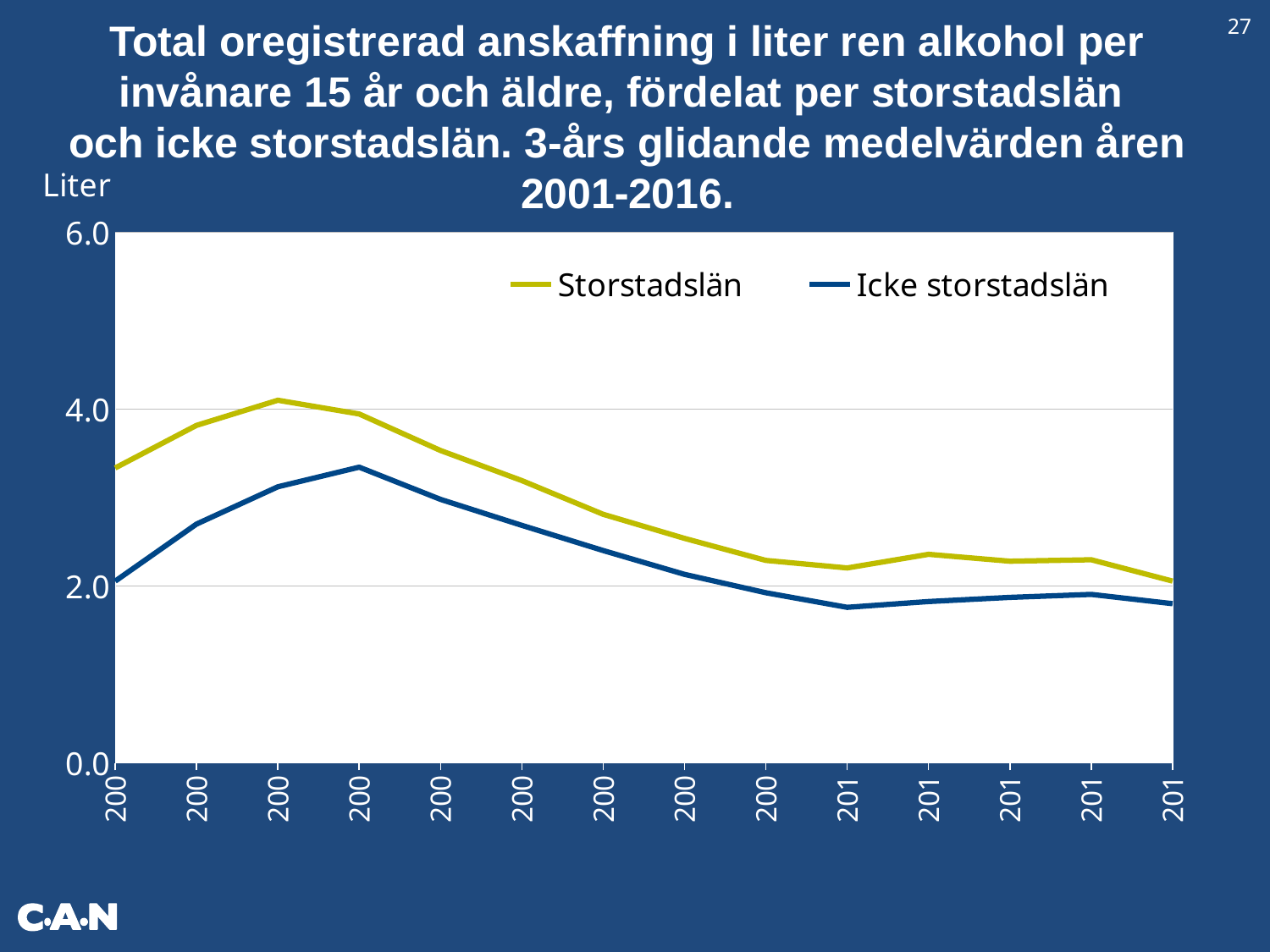
Is the peak value of the Icke storstadslän series greater or less than 4.0? less Is the value of Icke storstadslän at the last point on the x axis greater or less than 2.0? less Does the Storstadslän series rise or fall from its peak to the last point on the x axis? fall What kind of chart is shown on the slide? line chart What are the two series named in the legend? Storstadslän and Icke storstadslän How many series does the legend list? 2 Is the value of Storstadslän at the first point on the x axis greater or less than 2.0? greater Which series reaches the highest value anywhere on the chart? Storstadslän What unit label is shown above the y axis? Liter Which series has the higher value at the last point on the x axis? Storstadslän How many data points are plotted along the x axis for each series? 14 Which series has the higher value at the first point on the x axis? Storstadslän